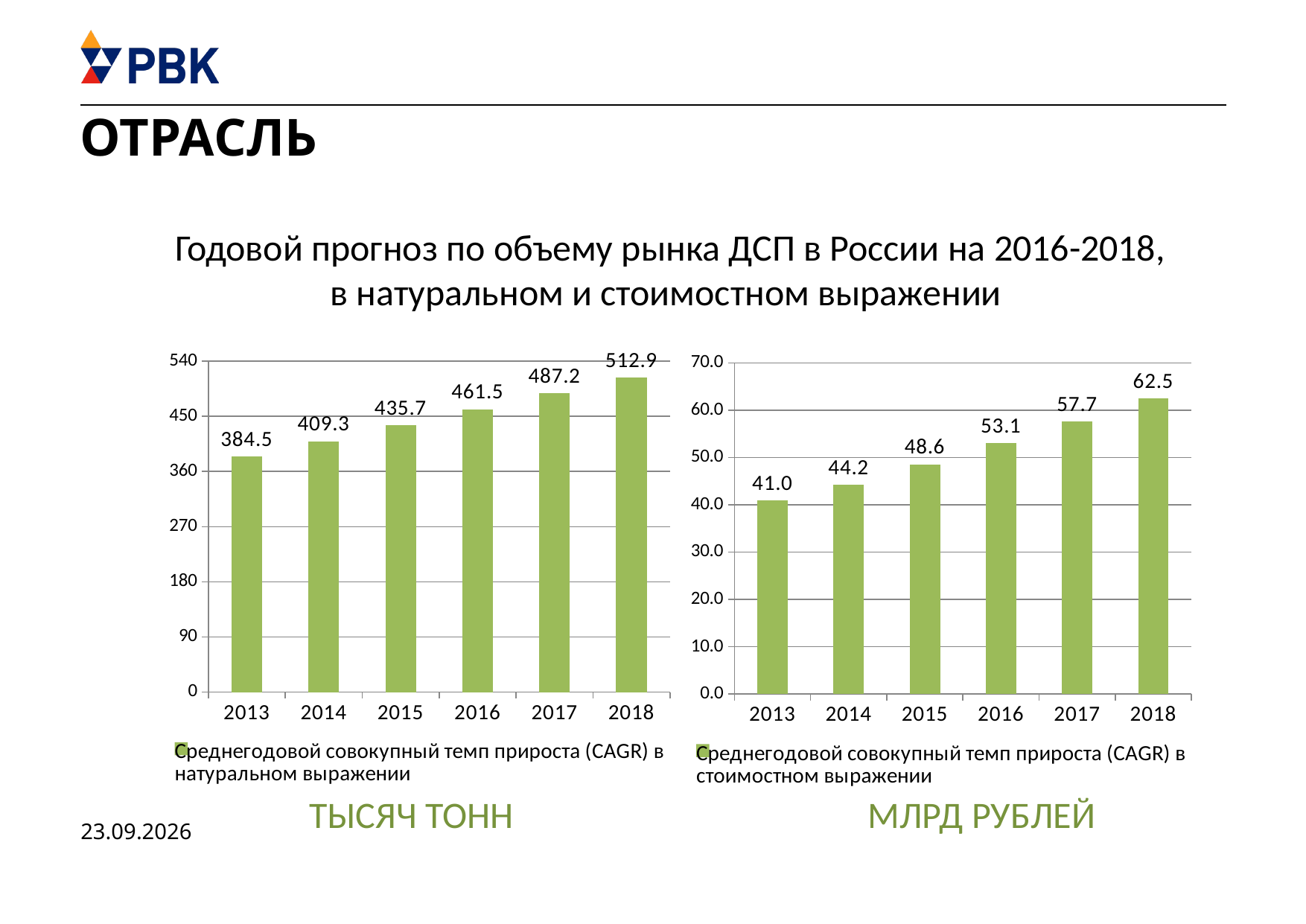
In the left chart (ТЫСЯЧ ТОНН), which year has the highest value? 2018 In the left chart (ТЫСЯЧ ТОНН), is the value for 2016 greater or less than 450? greater In the right chart (МЛРД РУБЛЕЙ), do the values rise or fall from 2013 to 2018? rise In the left chart (ТЫСЯЧ ТОНН), what is the value for 2015? 435.7 In the right chart (МЛРД РУБЛЕЙ), what is the difference between the values for 2017 and 2016? 4.6 What kind of chart is the left chart (ТЫСЯЧ ТОНН)? bar chart How many series does the legend of the left chart (ТЫСЯЧ ТОНН) list? 1 In the left chart (ТЫСЯЧ ТОНН), what is the difference between the values for 2018 and 2013? 128.4 In the right chart (МЛРД РУБЛЕЙ), which year has the lowest value? 2013 In the right chart (МЛРД РУБЛЕЙ), what is the value for 2016? 53.1 How many years are shown on the x axis of the right chart (МЛРД РУБЛЕЙ)? 6 In the right chart (МЛРД РУБЛЕЙ), which is larger, the value for 2014 or the value for 2015? 2015